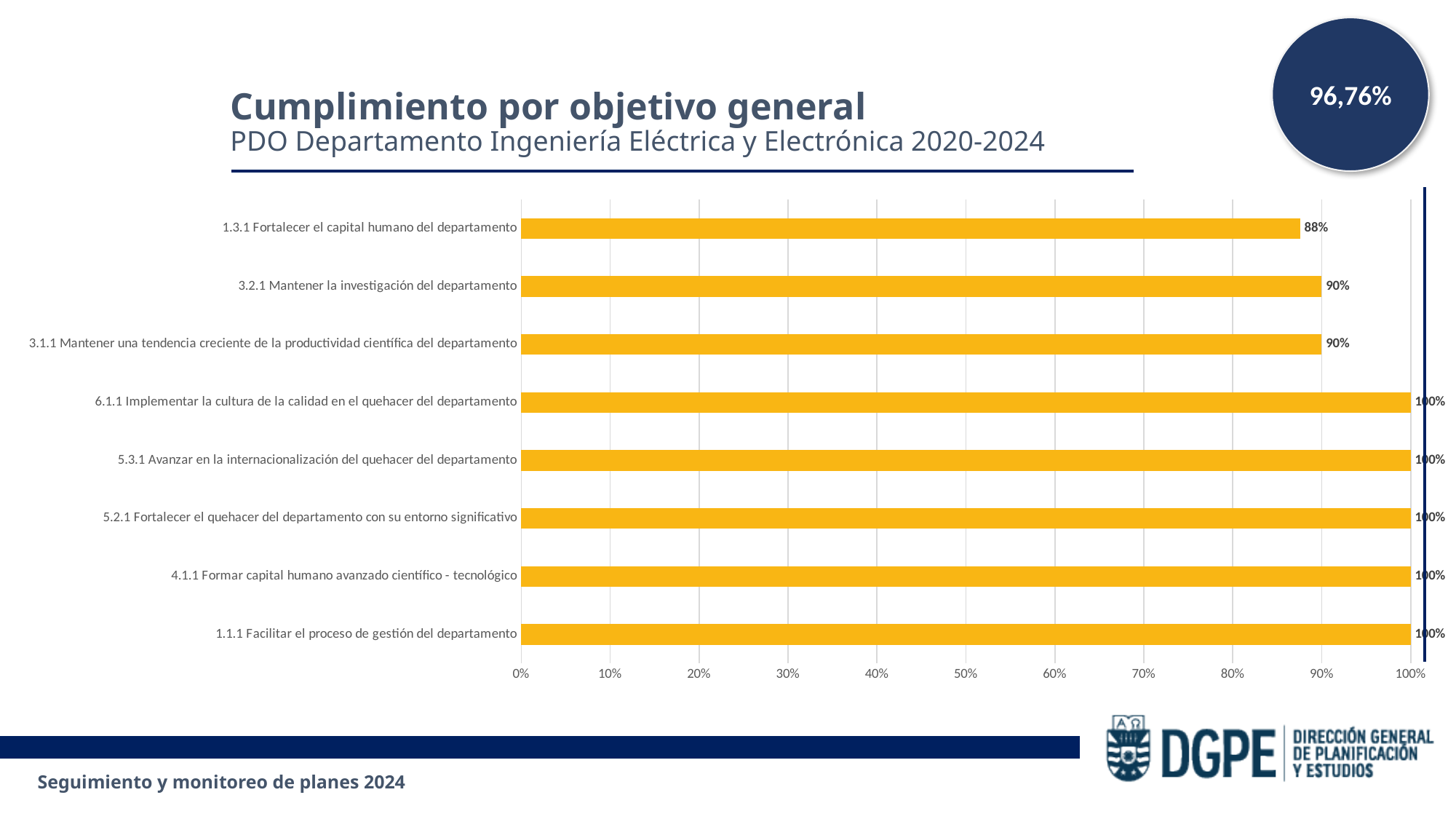
What is the difference between the value for 1.1.1 Facilitar el proceso de gestión del departamento and the value for 1.3.1 Fortalecer el capital humano del departamento? 12% What is the value for 1.3.1 Fortalecer el capital humano del departamento? 88% What is the value for 1.1.1 Facilitar el proceso de gestión del departamento? 100% What kind of chart is shown on the slide? Bar chart What is the difference between the value for 3.2.1 Mantener la investigación del departamento and the value for 1.3.1 Fortalecer el capital humano del departamento? 2% What is the title of the chart on the slide? Cumplimiento por objetivo general Which objective has the lowest value? 1.3.1 Fortalecer el capital humano del departamento How many objectives are shown in the chart? 8 What is the value for 3.2.1 Mantener la investigación del departamento? 90% How many objectives have a value of 100%? 5 Which is larger, the value for 4.1.1 Formar capital humano avanzado científico - tecnológico or the value for 3.2.1 Mantener la investigación del departamento? 4.1.1 Formar capital humano avanzado científico - tecnológico What is the value for 3.1.1 Mantener una tendencia creciente de la productividad científica del departamento? 90%